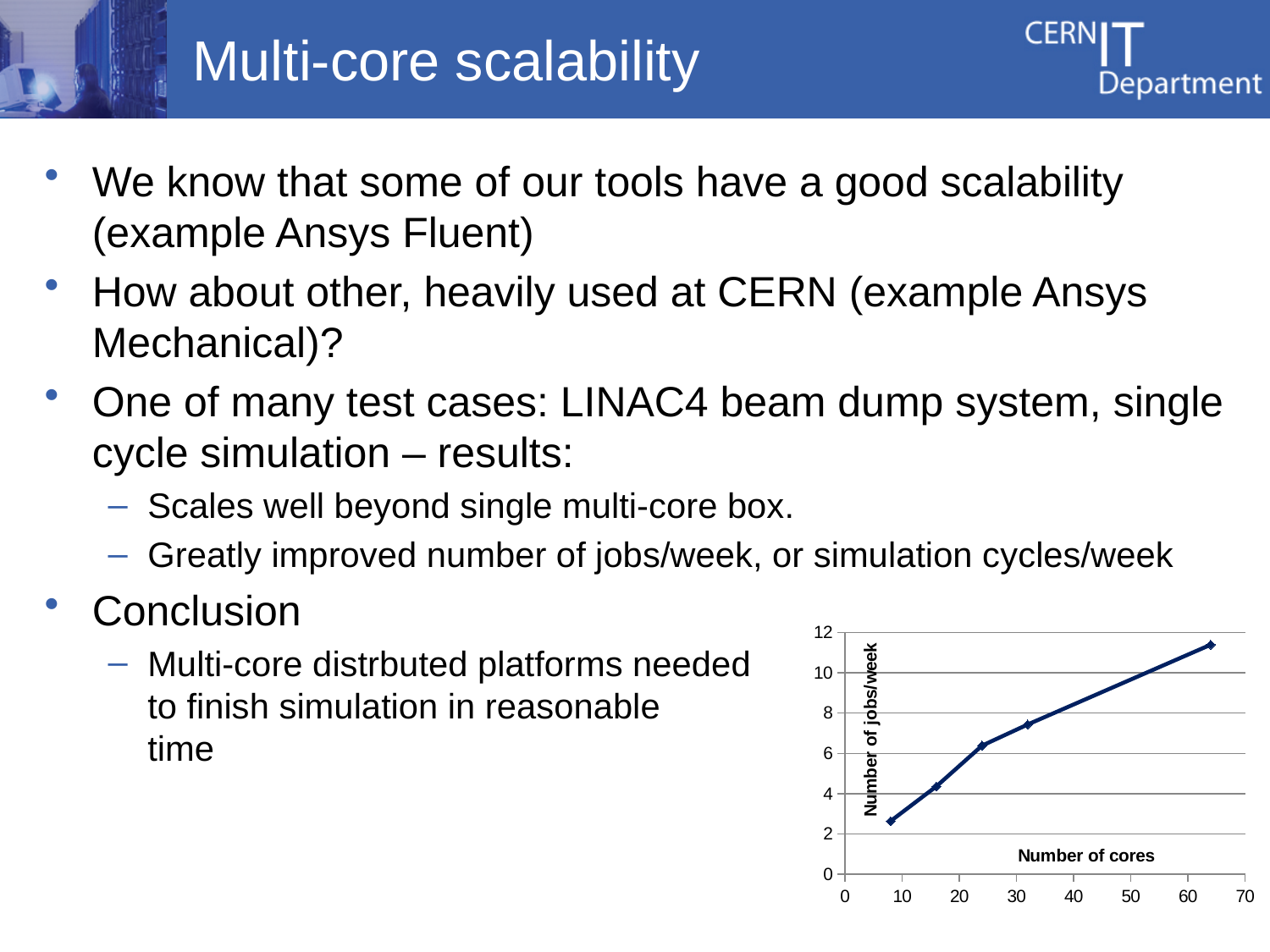
Which point has the highest number of jobs/week: the leftmost or the rightmost? the rightmost Is the value for the leftmost point (fewest cores) greater or less than 4 jobs/week? less Is the value for the fourth point from the left greater or less than 8 jobs/week? less What is the maximum value shown on the y axis of the chart? 12 What kind of chart is shown on the slide? line chart How many data points are plotted on the line in the chart? 5 Is the value for the second point from the left greater or less than 6 jobs/week? less What is the title of the y axis of the chart? Number of jobs/week What is the title of the x axis of the chart? Number of cores Does the number of jobs/week rise or fall as the number of cores increases? rise